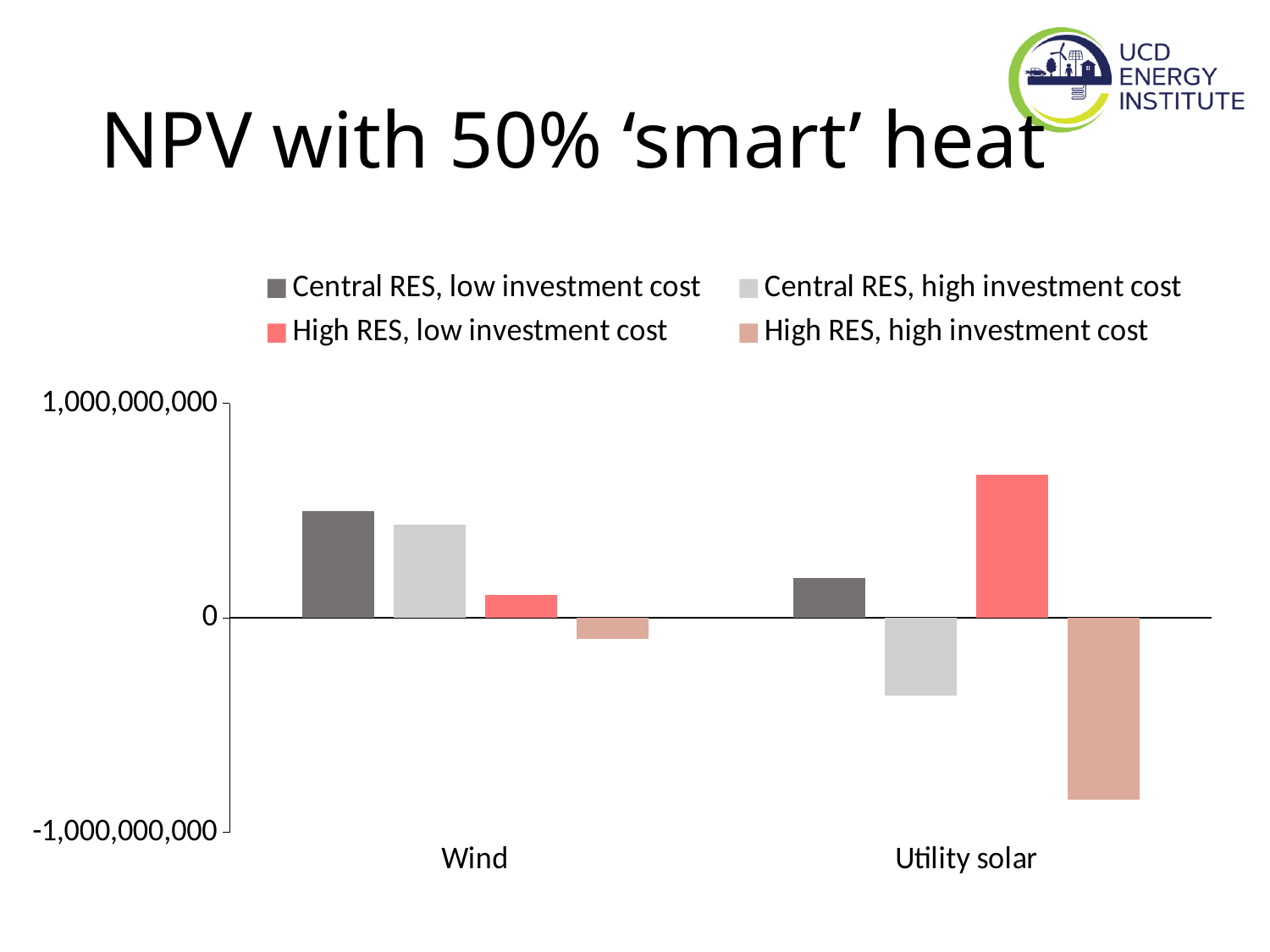
Which series has the lowest value for Wind? High RES, high investment cost What type of chart is shown on the slide? bar chart Which is larger: Central RES, low investment cost for Wind or High RES, low investment cost for Utility solar? High RES, low investment cost for Utility solar Which colour represents the High RES, low investment cost series in the legend? red What is the title of the chart slide? NPV with 50% 'smart' heat How many series does the legend list? 4 Which series has the lowest value for Utility solar? High RES, high investment cost Is the value for High RES, low investment cost under Wind greater or less than 0? greater Which series has the highest value for Wind? Central RES, low investment cost How many categories are shown on the x axis? 2 Is the value for Central RES, high investment cost under Utility solar greater or less than 0? less Which series has the highest value for Utility solar? High RES, low investment cost